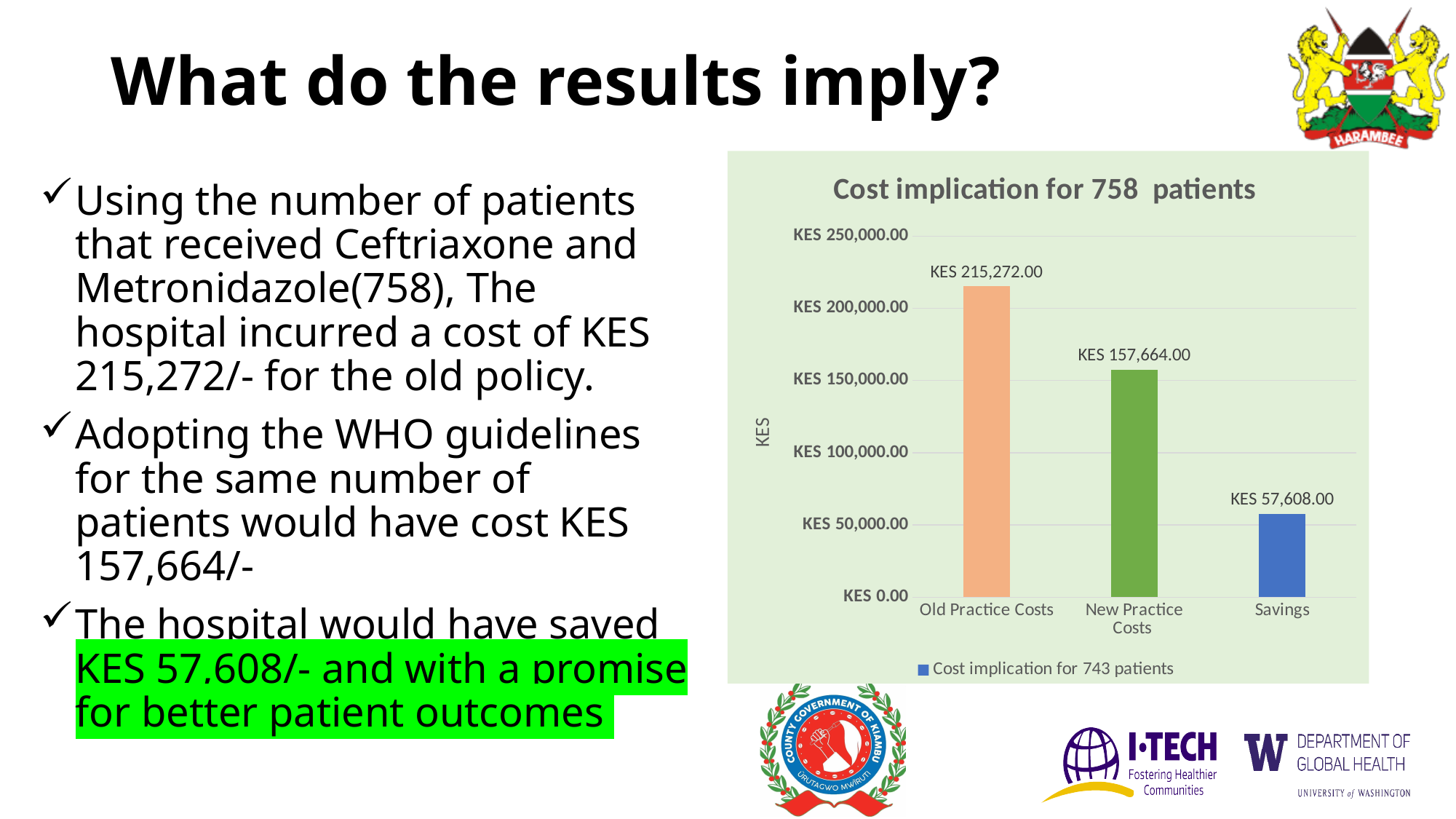
What is the difference between Old Practice Costs and New Practice Costs? KES 57,608.00 How many categories are shown on the x axis? 3 Is the value for Savings greater or less than KES 100,000.00? less Which is larger, New Practice Costs or Savings? New Practice Costs What is the value for Savings? KES 57,608.00 Which category has the highest value? Old Practice Costs What is the value for New Practice Costs? KES 157,664.00 What kind of chart is shown? bar chart What is the legend entry shown below the chart? Cost implication for 743 patients What is the value for Old Practice Costs? KES 215,272.00 What is the title of the chart? Cost implication for 758 patients Which category has the lowest value? Savings